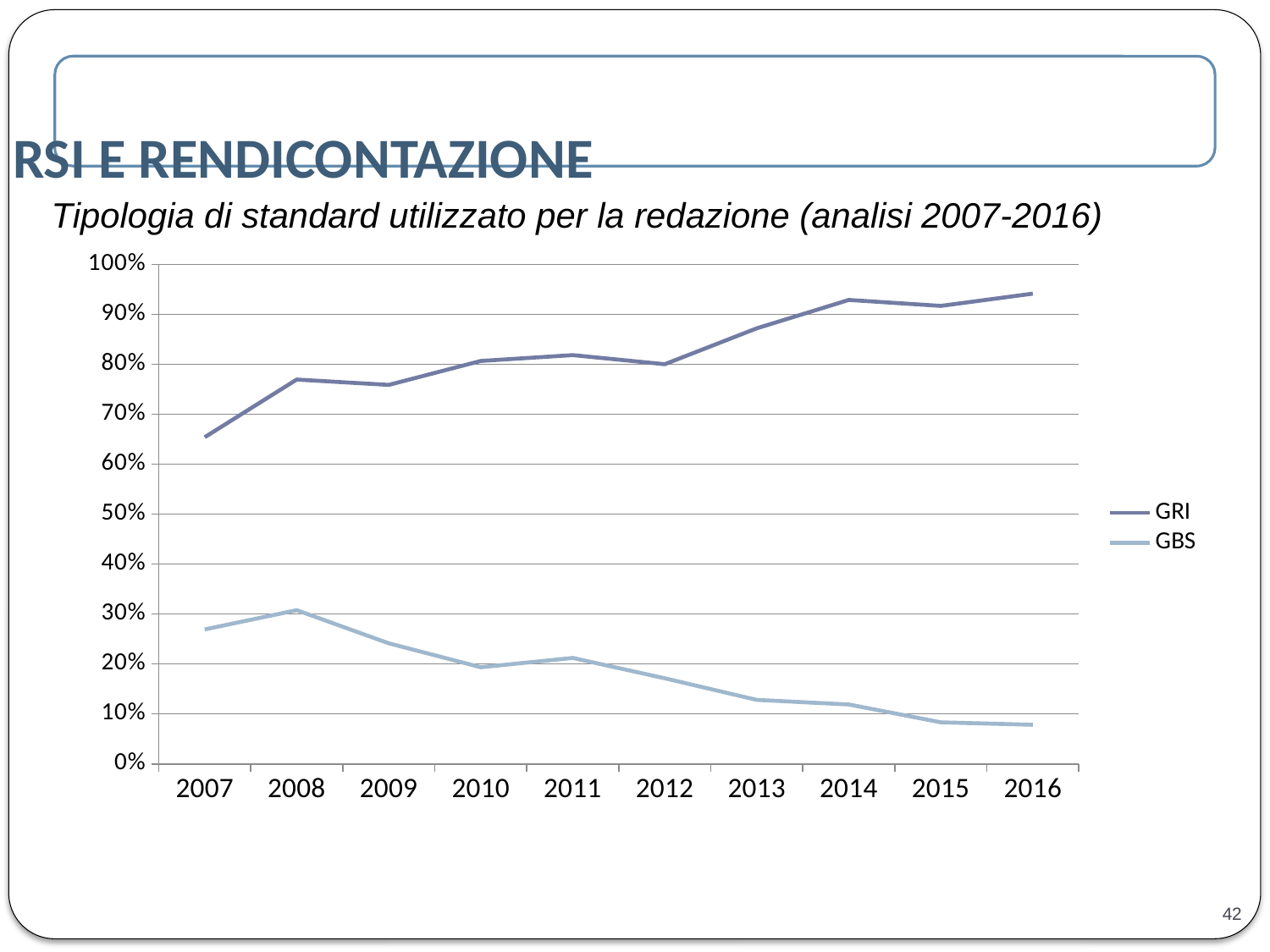
How many years are shown on the x axis? 10 Is the GRI value for 2016 greater or less than 90%? greater Which series is plotted with the darker line? GRI Is the GRI value for 2007 greater or less than 70%? less In which year is the GRI series at its lowest? 2007 Is the GBS value for 2012 greater or less than 20%? less What kind of chart is shown on the slide? line chart How many series does the legend list? 2 Does the GBS series generally rise or fall from 2008 to 2016? fall Which is larger, the GRI value for 2012 or for 2013? 2013 In which year is the GBS series at its highest? 2008